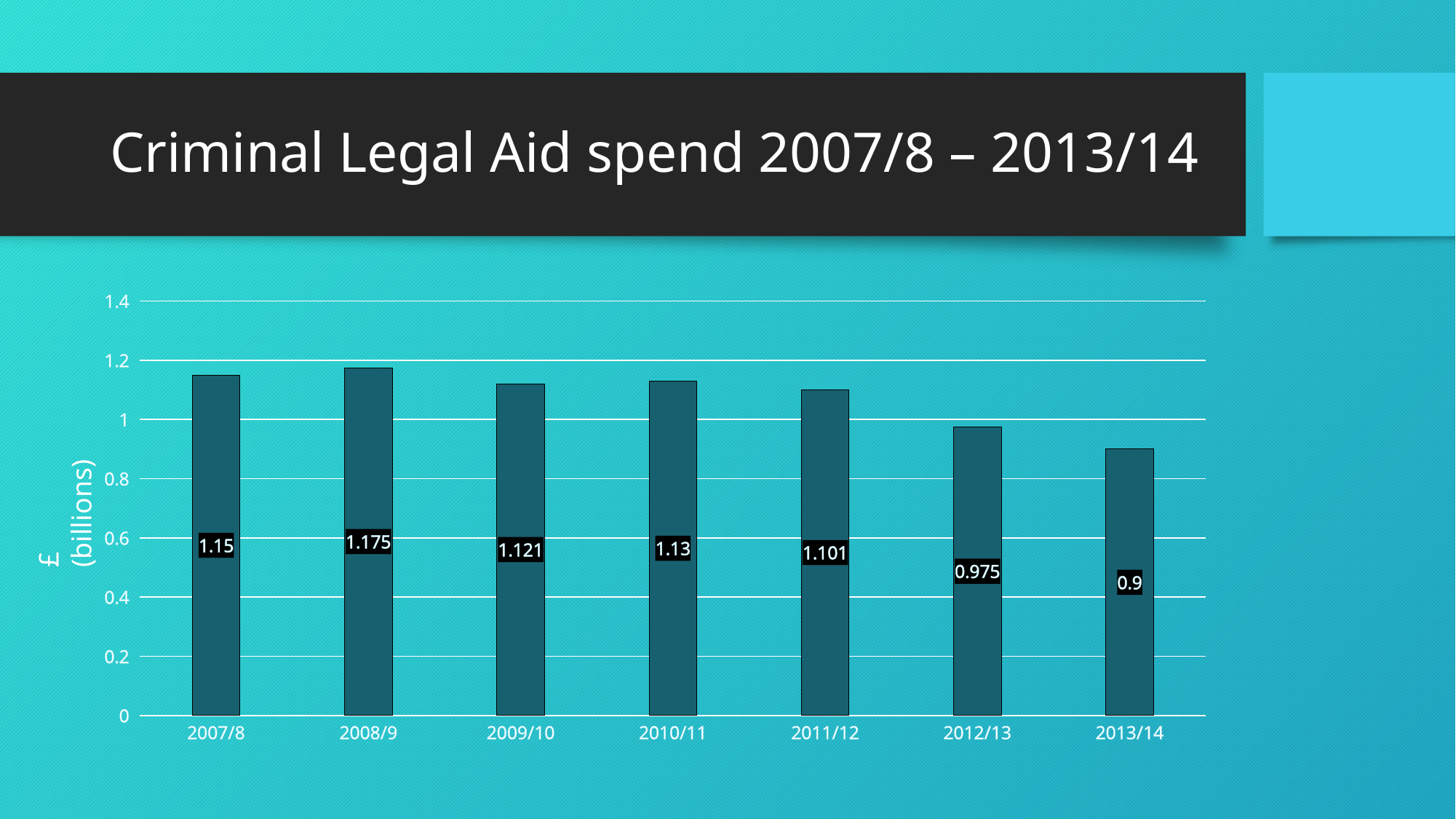
Is the value for 2012/13 greater or less than 1? less Which is larger, the value for 2009/10 or the value for 2010/11? 2010/11 What is the value shown for 2011/12? 1.101 Which year has the highest Criminal Legal Aid spend? 2008/9 What is the Criminal Legal Aid spend for 2007/8? 1.15 Which year has the lowest Criminal Legal Aid spend? 2013/14 How many years are shown on the x axis? 7 What is the value shown for 2013/14? 0.9 What is the label on the vertical axis? £ (billions) What is the difference between the values for 2008/9 and 2013/14? 0.275 What kind of chart is shown on the slide? bar chart What is the difference between the values for 2012/13 and 2013/14? 0.075